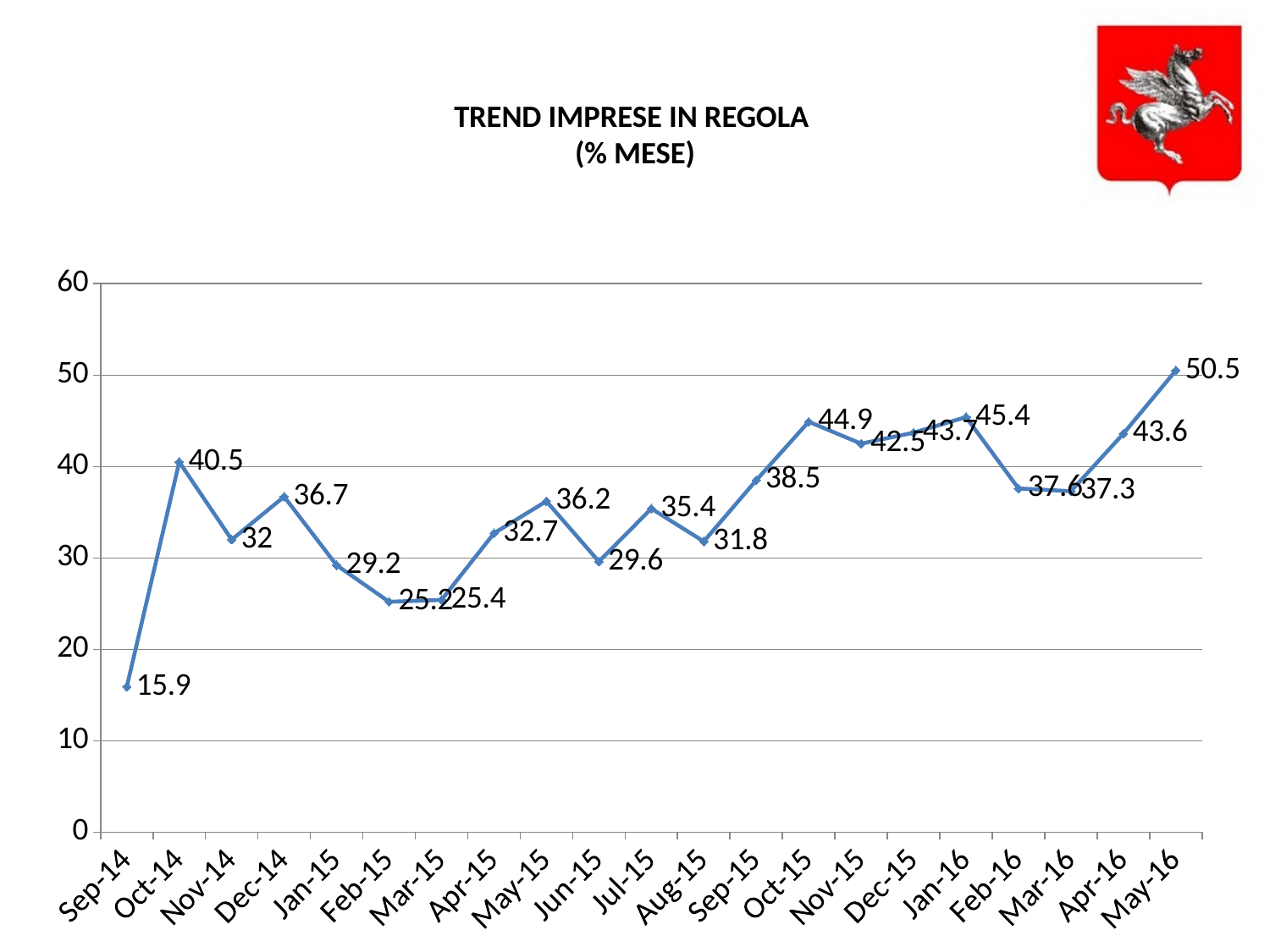
What type of chart is shown on the slide? Line chart What is the title of the chart? TREND IMPRESE IN REGOLA (% MESE) Is the value for Apr-16 greater or less than 40? greater Which month has the highest value? May-16 What is the value for Feb-15? 25.2 Which is larger, the value for Oct-14 or the value for Dec-14? Oct-14 What is the value for Oct-15? 44.9 What is the value for Jan-16? 45.4 How many months are plotted on the chart? 21 What is the value for Sep-14? 15.9 What is the difference between the values for May-16 and Sep-14? 34.6 Which month has the lowest value? Sep-14